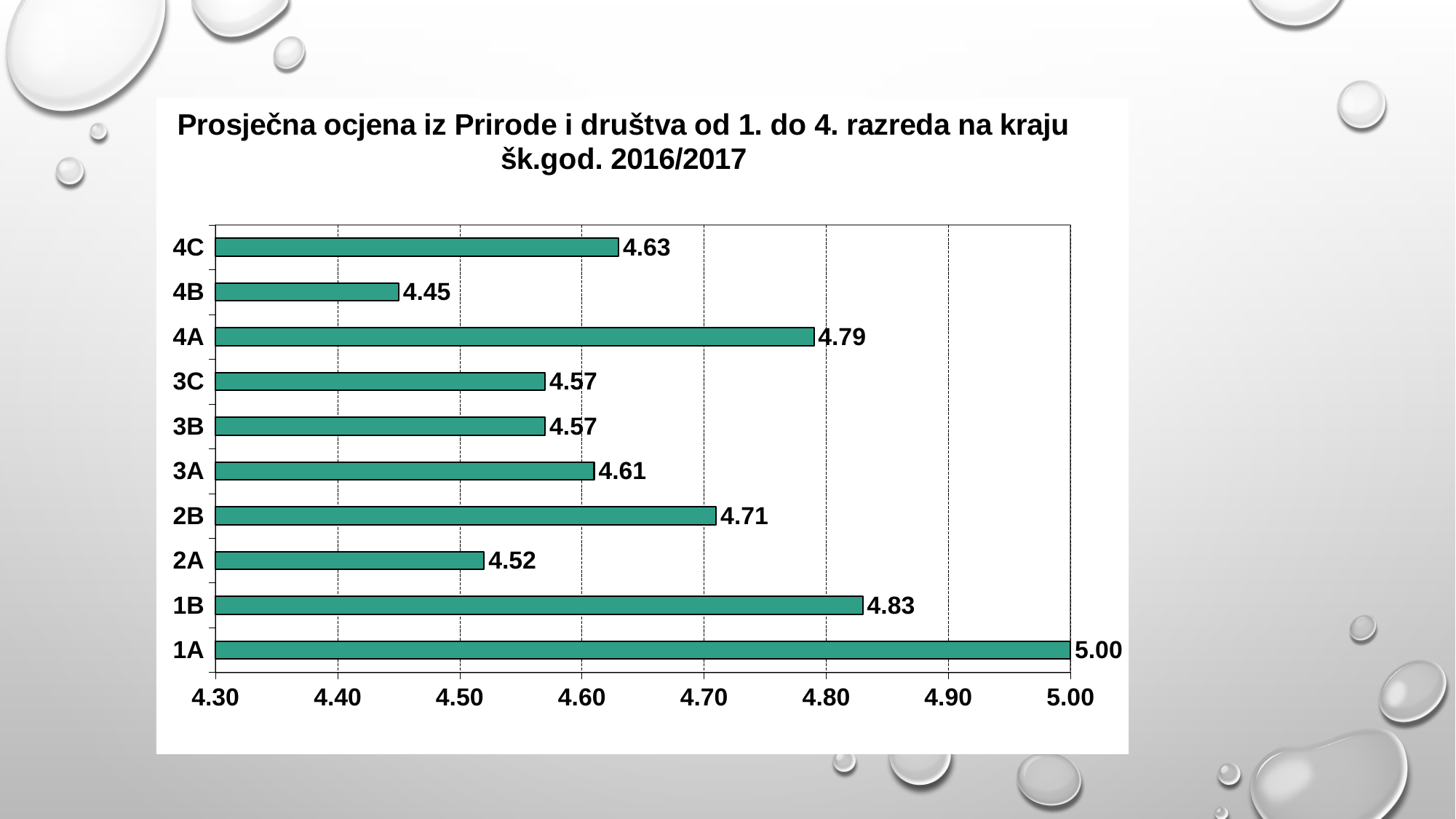
What kind of chart is shown on the slide? Bar chart Is the value for 2B greater or less than 4.70? greater What is the average grade for class 1A? 5.00 Which class has the lowest average grade? 4B Which class has the highest average grade? 1A What is the title of the chart? Prosječna ocjena iz Prirode i društva od 1. do 4. razreda na kraju šk.god. 2016/2017 How many classes are shown in the chart? 10 Which class has a higher average grade, 4C or 3A? 4C What is the average grade for class 2B? 4.71 What is the difference between the average grades of 1B and 2A? 0.31 What is the average grade for class 4B? 4.45 What is the difference between the average grades of 4A and 4B? 0.34